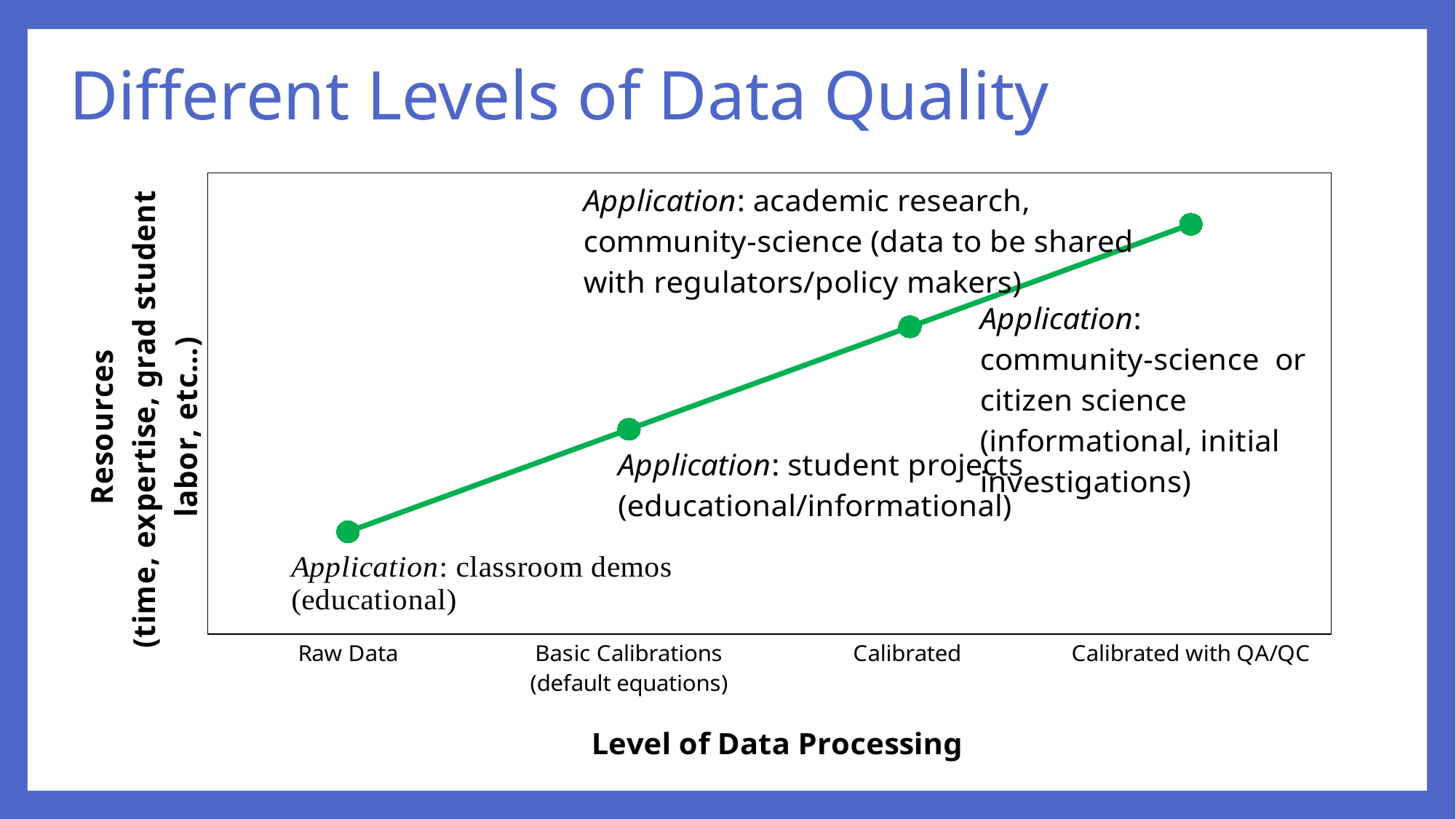
How many categories are shown on the x axis? 4 Do the plotted values rise or fall as the level of data processing increases along the x axis? Rise Which level of data processing requires the most resources according to the chart? Calibrated with QA/QC Which level of data processing requires the fewest resources according to the chart? Raw Data What is the title of the x axis? Level of Data Processing Which requires fewer resources, Raw Data or Calibrated with QA/QC? Raw Data Which requires more resources, Basic Calibrations (default equations) or Calibrated? Calibrated What kind of chart is shown on the slide? Line chart How many data points are plotted on the line? 4 What application is listed for Raw Data? Classroom demos (educational)